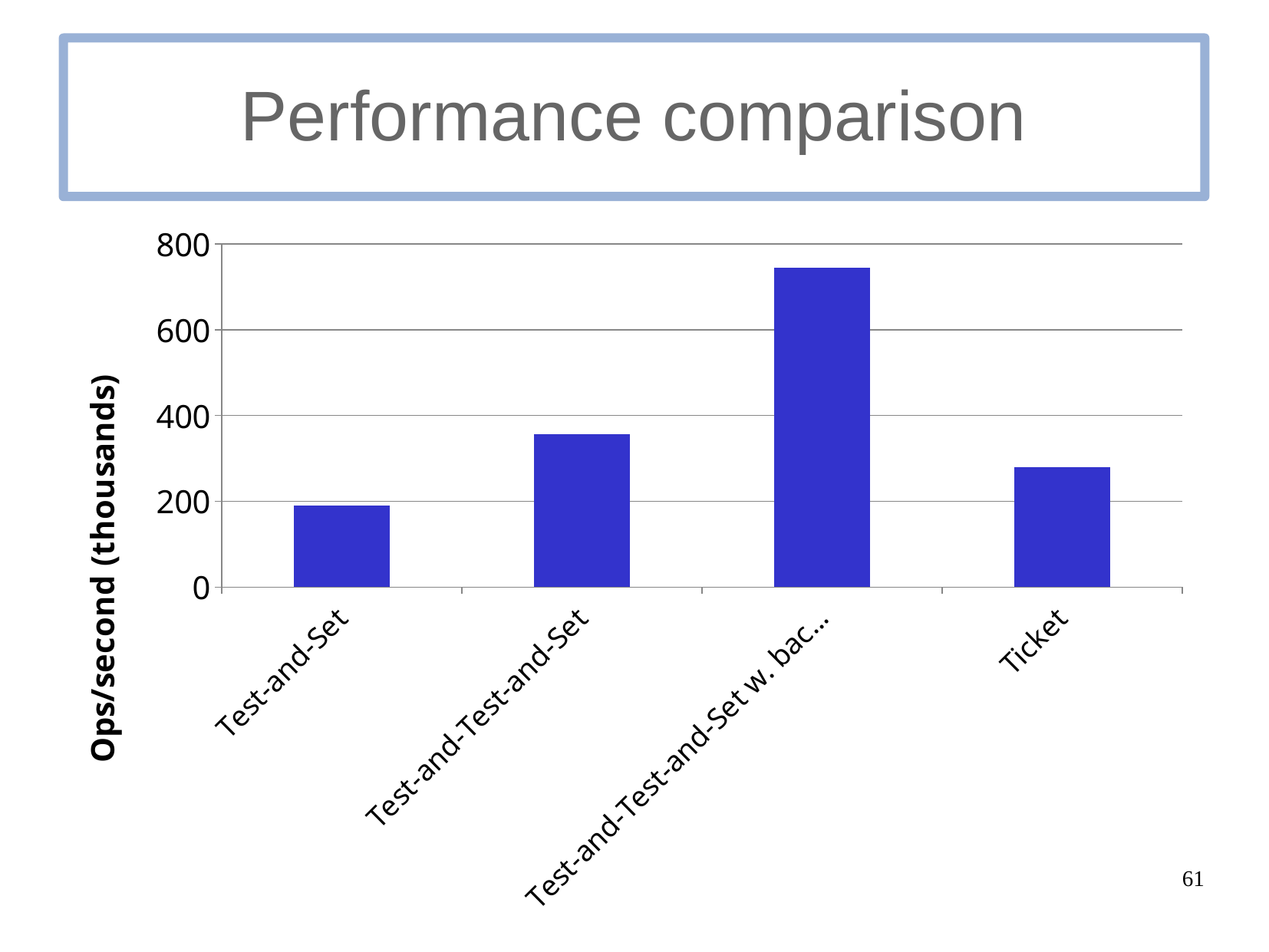
Is the value for Ticket greater or less than 400? less Is the value for Test-and-Test-and-Set greater or less than 400? less Which is larger, the value for Test-and-Test-and-Set or the value for Ticket? Test-and-Test-and-Set What kind of chart is shown on the slide? bar chart Is the value for Ticket greater or less than 200? greater What is the title of the slide containing the chart? Performance comparison Which category has the highest value in the chart? Test-and-Test-and-Set w. bac... (third bar from the left) What is the label of the vertical axis of the chart? Ops/second (thousands) Which is larger, the value for Ticket or the value for Test-and-Set? Ticket How many categories are plotted in the chart? 4 Which category has the lowest value in the chart? Test-and-Set